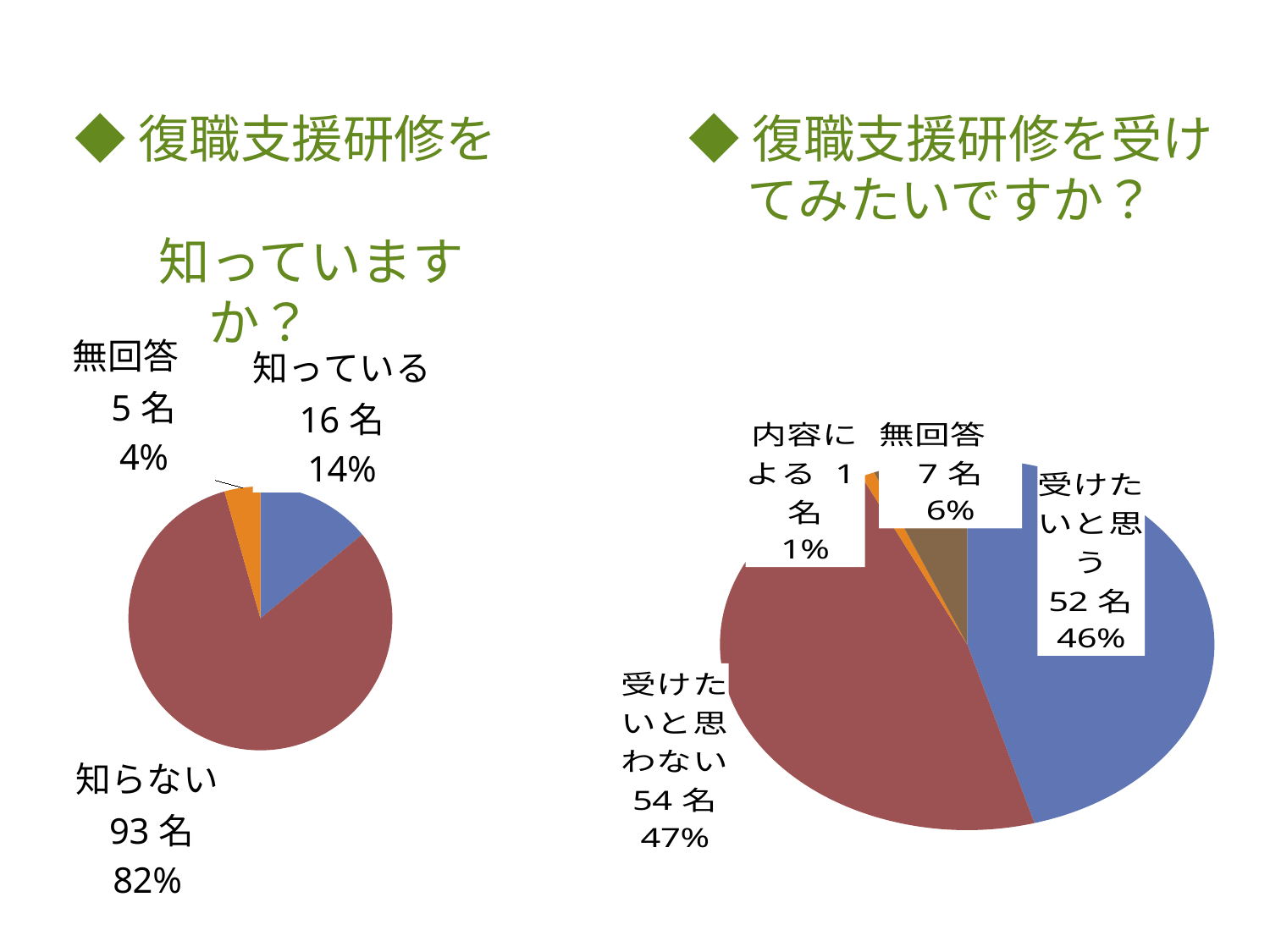
In the left pie chart (復職支援研修を知っていますか？), what percentage share does 知っている have? 14% In the left pie chart (復職支援研修を知っていますか？), how many people answered 知らない? 93名 In the left pie chart (復職支援研修を知っていますか？), which category has the smallest slice? 無回答 In the left pie chart (復職支援研修を知っていますか？), how many categories are shown? 3 In the left pie chart (復職支援研修を知っていますか？), what is the difference in number of people between 知らない and 知っている? 77名 In the right pie chart (復職支援研修を受けてみたいですか？), how many categories are shown? 4 In the right pie chart (復職支援研修を受けてみたいですか？), which category has the smallest slice? 内容による In the right pie chart (復職支援研修を受けてみたいですか？), how many people answered 受けたいと思う? 52名 In the left pie chart (復職支援研修を知っていますか？), which category has the largest slice? 知らない In the right pie chart (復職支援研修を受けてみたいですか？), what percentage share does 無回答 have? 6% In the right pie chart (復職支援研修を受けてみたいですか？), what is the difference in number of people between 受けたいと思わない and 受けたいと思う? 2名 What type of chart is used on the right side of the slide (復職支援研修を受けてみたいですか？)? Pie chart